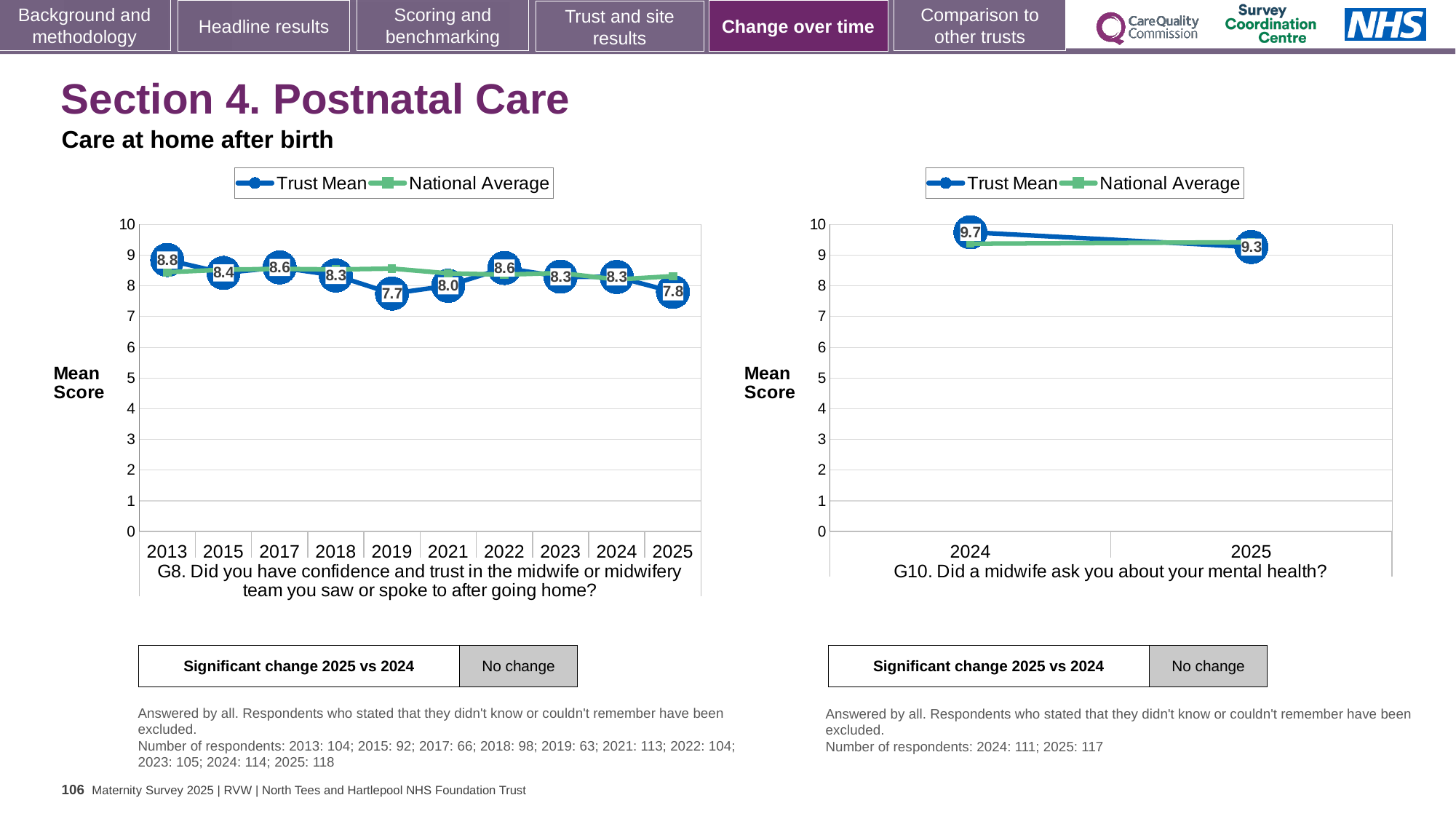
In the G10 chart (right), what is the Trust Mean for 2024? 9.7 In the G10 chart (right), is the Trust Mean for 2024 greater or less than 9? greater In the G10 chart (right), what is the Trust Mean for 2025? 9.3 In the G8 chart (left), what is the Trust Mean for 2013? 8.8 In the G10 chart (right), does the Trust Mean rise or fall from 2024 to 2025? fall In the G8 chart (left), what is the Trust Mean for 2019? 7.7 In the G8 chart (left), which year has the highest Trust Mean? 2013 In the G8 chart (left), what is the Trust Mean for 2025? 7.8 In the G8 chart (left), what is the difference between the Trust Mean for 2024 and 2025? 0.5 In the G8 chart (left), which year has the lowest Trust Mean? 2019 In the G8 chart (left), how many years are shown on the x axis? 10 How many series does the legend of the G8 chart (left) list? 2